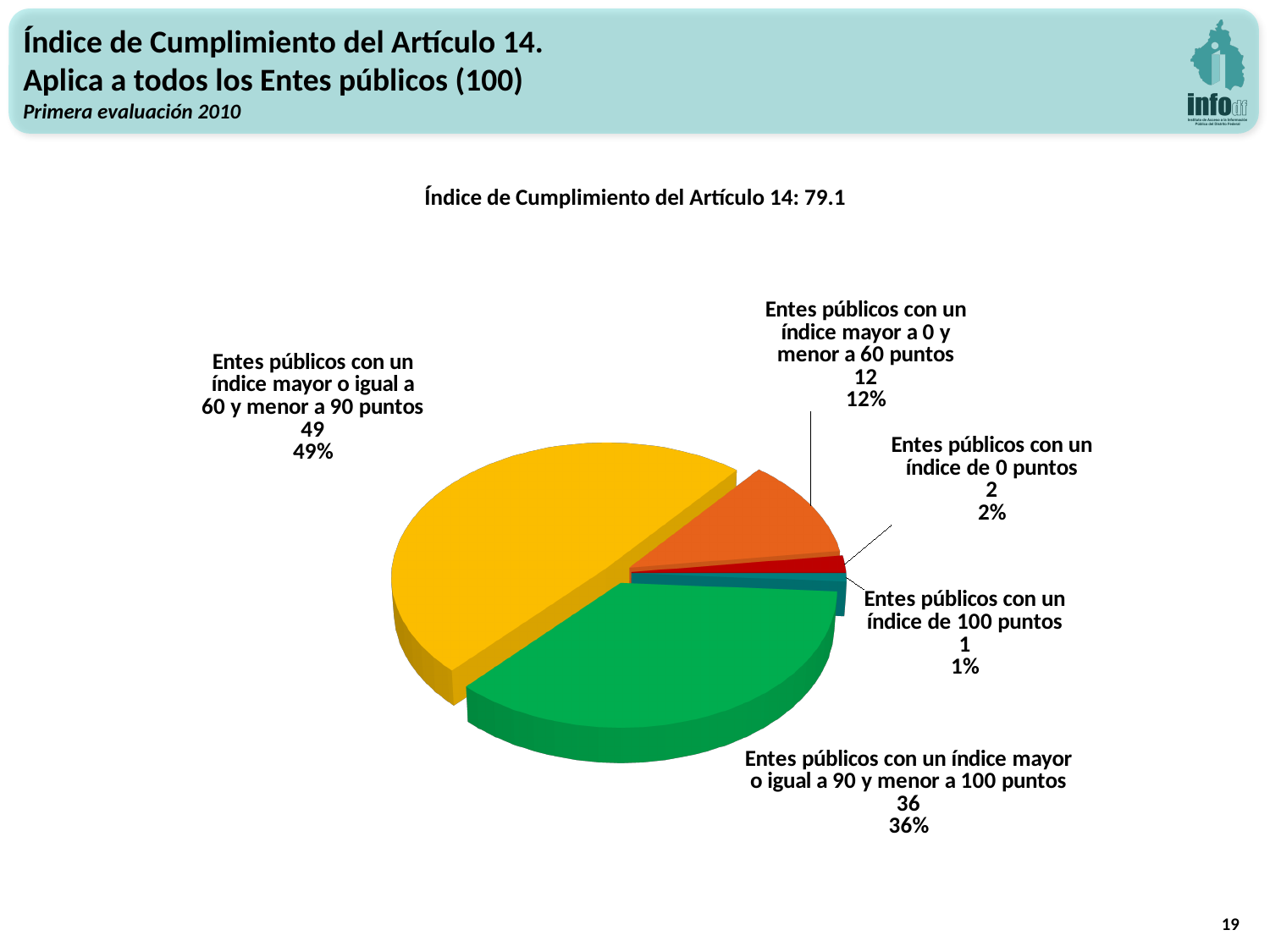
How many slices does the pie chart have? 5 What share of the pie is for entes públicos with an index of 0 points? 2% Which is larger: the number of entes públicos with an index greater than 0 and less than 60 points, or those with an index of 0 points? Entes públicos con un índice mayor a 0 y menor a 60 puntos How many entes públicos have an index greater than or equal to 60 and less than 90 points? 49 What percentage of the pie corresponds to entes públicos with an index greater than or equal to 90 and less than 100 points? 36% How many entes públicos have an index of 100 points? 1 Which category has the smallest slice of the pie? Entes públicos con un índice de 100 puntos How many entes públicos have an index greater than 0 and less than 60 points? 12 What is the difference between the number of entes públicos with an index of 60 to under 90 points and those with 90 to under 100 points? 13 What kind of chart is shown on the slide? pie chart What is the value of the Índice de Cumplimiento del Artículo 14 stated above the chart? 79.1 Which category has the largest slice of the pie? Entes públicos con un índice mayor o igual a 60 y menor a 90 puntos